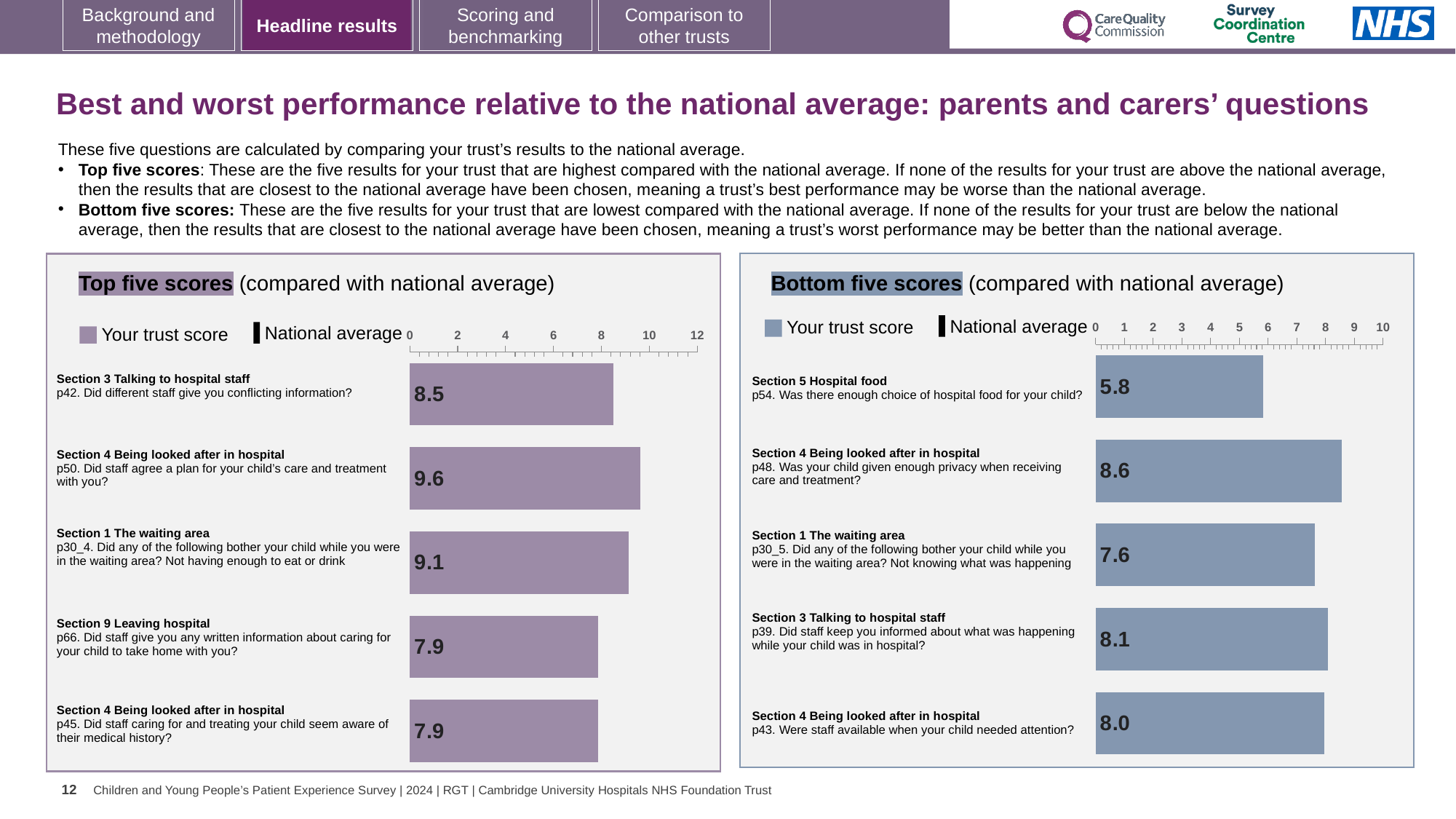
How many questions are shown in the Bottom five scores chart? 5 In the Top five scores chart, which has the larger trust score: p42 or p30_4? p30_4 In the Bottom five scores chart, which question has the lowest trust score? p54. Was there enough choice of hospital food for your child? In the Bottom five scores chart, which question has the highest trust score? p48. Was your child given enough privacy when receiving care and treatment? How many series does the legend of the Top five scores chart list? 2 In the Bottom five scores chart, which has the larger trust score: p39 or p30_5? p39 What type of chart is the Top five scores chart? Bar chart In the Bottom five scores chart, what is the trust score for p54 (Was there enough choice of hospital food for your child?)? 5.8 In the Top five scores chart, what is the trust score for p50 (Did staff agree a plan for your child's care and treatment with you?)? 9.6 In the Bottom five scores chart, what is the difference between the trust scores for p48 and p54? 2.8 In the Top five scores chart, which question has the highest trust score? p50. Did staff agree a plan for your child's care and treatment with you? In the Top five scores chart, what is the difference between the trust scores for p50 and p66? 1.7